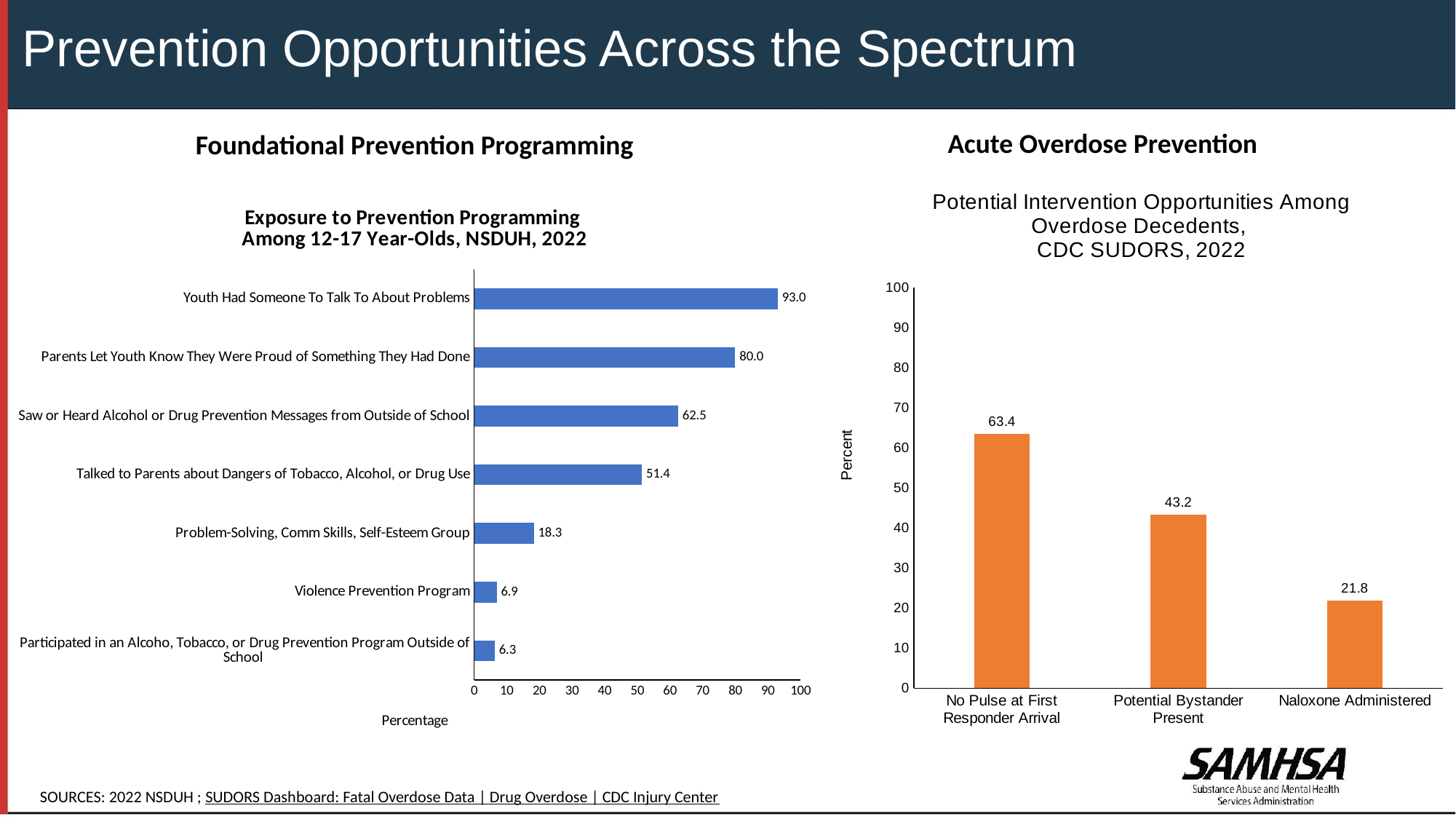
In the left chart (Exposure to Prevention Programming Among 12-17 Year-Olds), what is the x-axis label? Percentage In the left chart (Exposure to Prevention Programming Among 12-17 Year-Olds), what is the difference between 'Parents Let Youth Know They Were Proud of Something They Had Done' and 'Talked to Parents about Dangers of Tobacco, Alcohol, or Drug Use'? 28.6 In the left chart (Exposure to Prevention Programming Among 12-17 Year-Olds), how many categories are plotted? 7 In the left chart (Exposure to Prevention Programming Among 12-17 Year-Olds), what is the value for 'Youth Had Someone To Talk To About Problems'? 93.0 In the right chart (Potential Intervention Opportunities Among Overdose Decedents), what type of chart is shown? Bar chart In the right chart (Potential Intervention Opportunities Among Overdose Decedents), do the values rise or fall from left to right? Fall In the right chart (Potential Intervention Opportunities Among Overdose Decedents), which category has the highest value? No Pulse at First Responder Arrival In the right chart (Potential Intervention Opportunities Among Overdose Decedents), what is the difference between 'No Pulse at First Responder Arrival' and 'Naloxone Administered'? 41.6 In the left chart (Exposure to Prevention Programming Among 12-17 Year-Olds), what is the value for 'Violence Prevention Program'? 6.9 In the right chart (Potential Intervention Opportunities Among Overdose Decedents), what is the value for 'Potential Bystander Present'? 43.2 In the left chart (Exposure to Prevention Programming Among 12-17 Year-Olds), which category has the lowest value? Participated in an Alcoho, Tobacco, or Drug Prevention Program Outside of School In the right chart (Potential Intervention Opportunities Among Overdose Decedents), what is the y-axis label? Percent